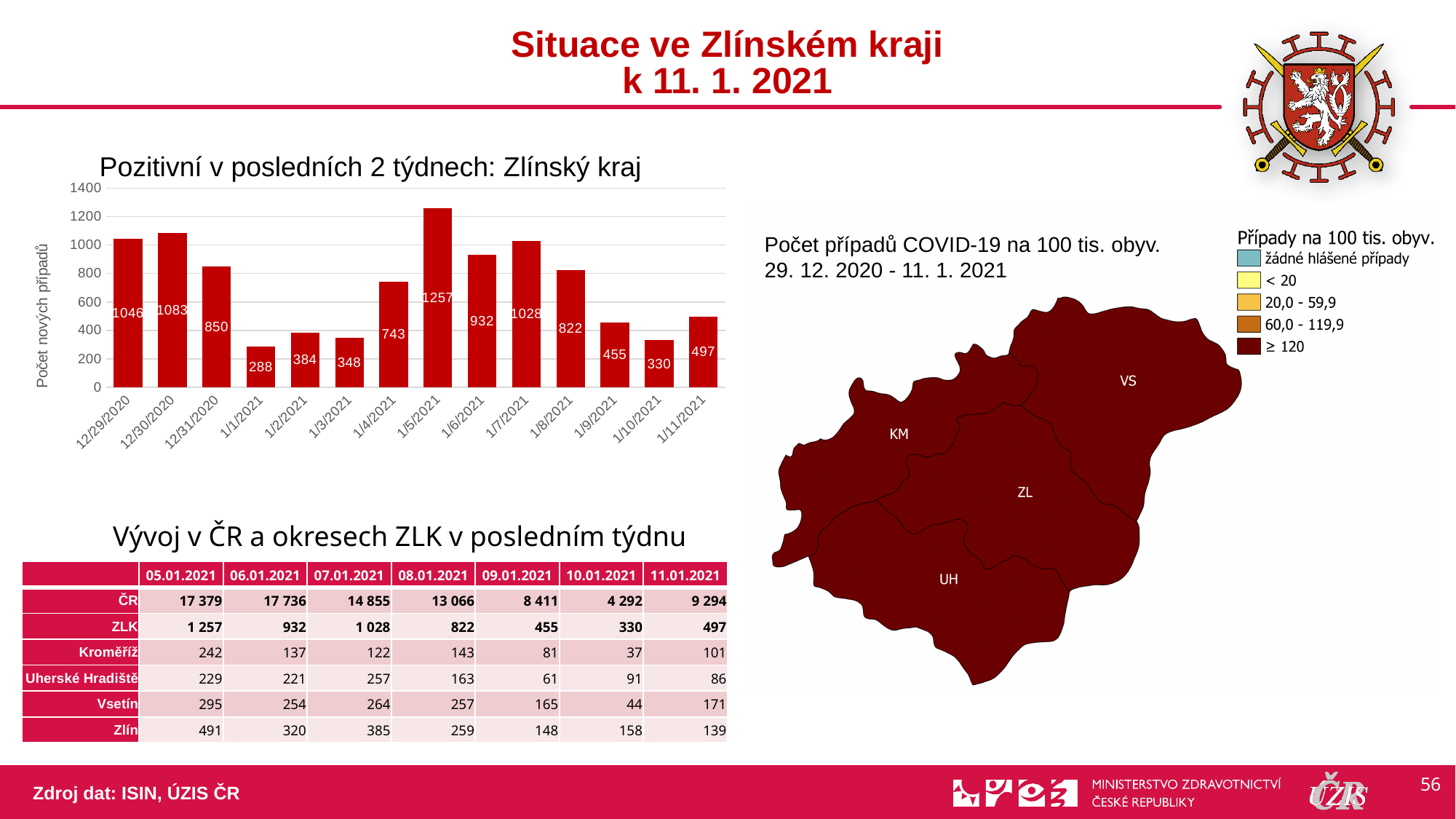
Which date has the lowest value in the bar chart? 1/1/2021 In the bar chart, what is the difference between the values for 1/5/2021 and 1/6/2021? 325 In the bar chart, what is the value for 1/10/2021? 330 In the bar chart, is the value for 1/11/2021 greater or less than 400? greater Which date has the highest value in the bar chart? 1/5/2021 In the bar chart, what is the difference between the values for 12/31/2020 and 1/1/2021? 562 In the bar chart, what is the value for 12/29/2020? 1046 In the bar chart, what is the value for 1/5/2021? 1257 In the bar chart, which is larger: the value for 12/30/2020 or the value for 1/7/2021? 12/30/2020 What is the y-axis label of the bar chart? Počet nových případů How many dates (bars) are shown in the bar chart? 14 What type of chart is used to show 'Pozitivní v posledních 2 týdnech: Zlínský kraj'? bar chart